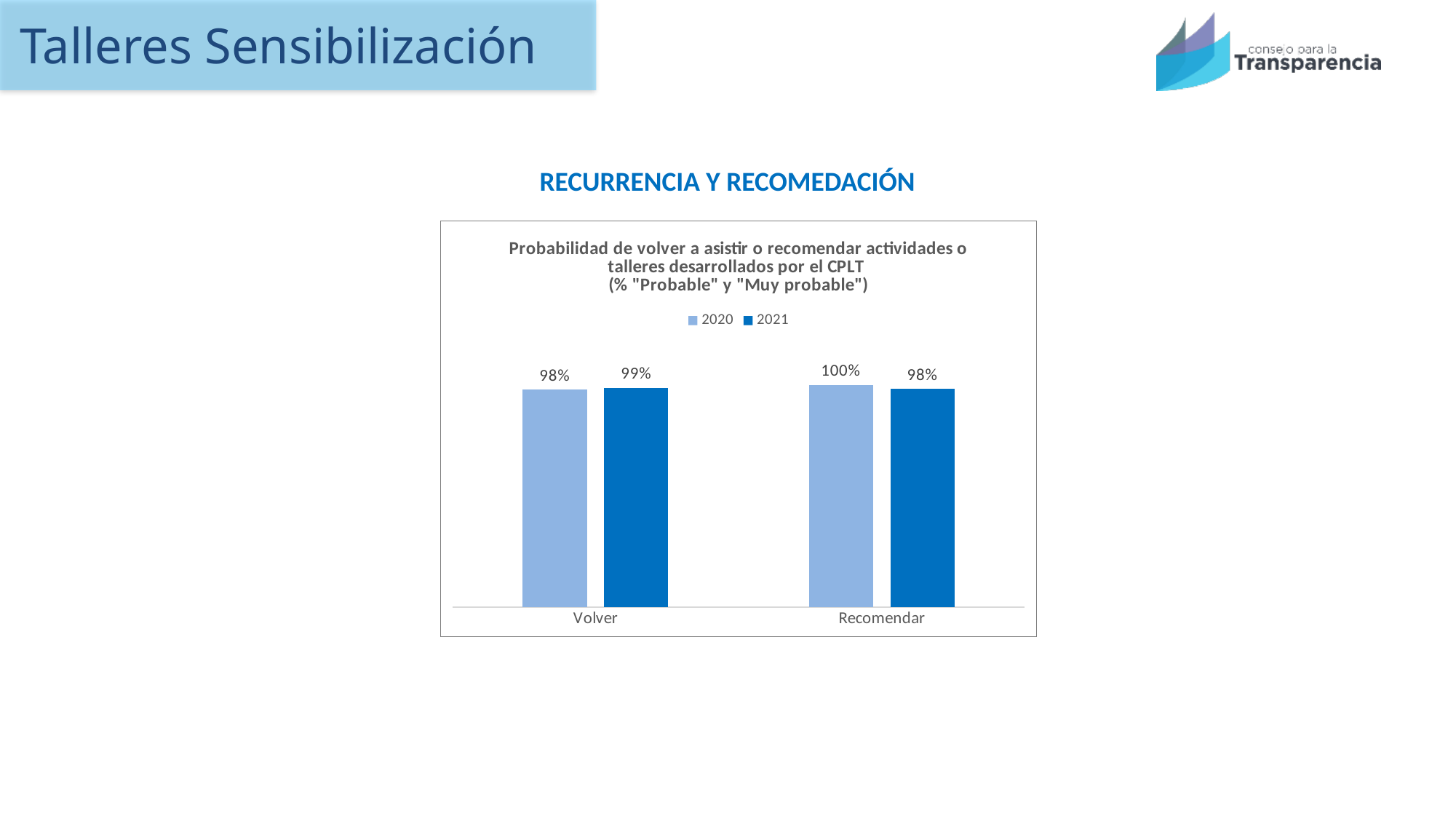
What is the difference between the 2020 and 2021 values for Recomendar? 2% What is the value for 2021 in the Volver category? 99% What is the difference between the 2021 and 2020 values for Volver? 1% Which category has the lowest value for the 2021 series? Recomendar Which series is shown in the darker blue colour? 2021 How many series does the legend list? 2 What kind of chart is shown on the slide? Bar chart What is the value for 2020 in the Recomendar category? 100% What is the value for 2021 in the Recomendar category? 98% What is the value for 2020 in the Volver category? 98% How many categories are shown on the x axis? 2 Which category has the highest value for the 2020 series? Recomendar